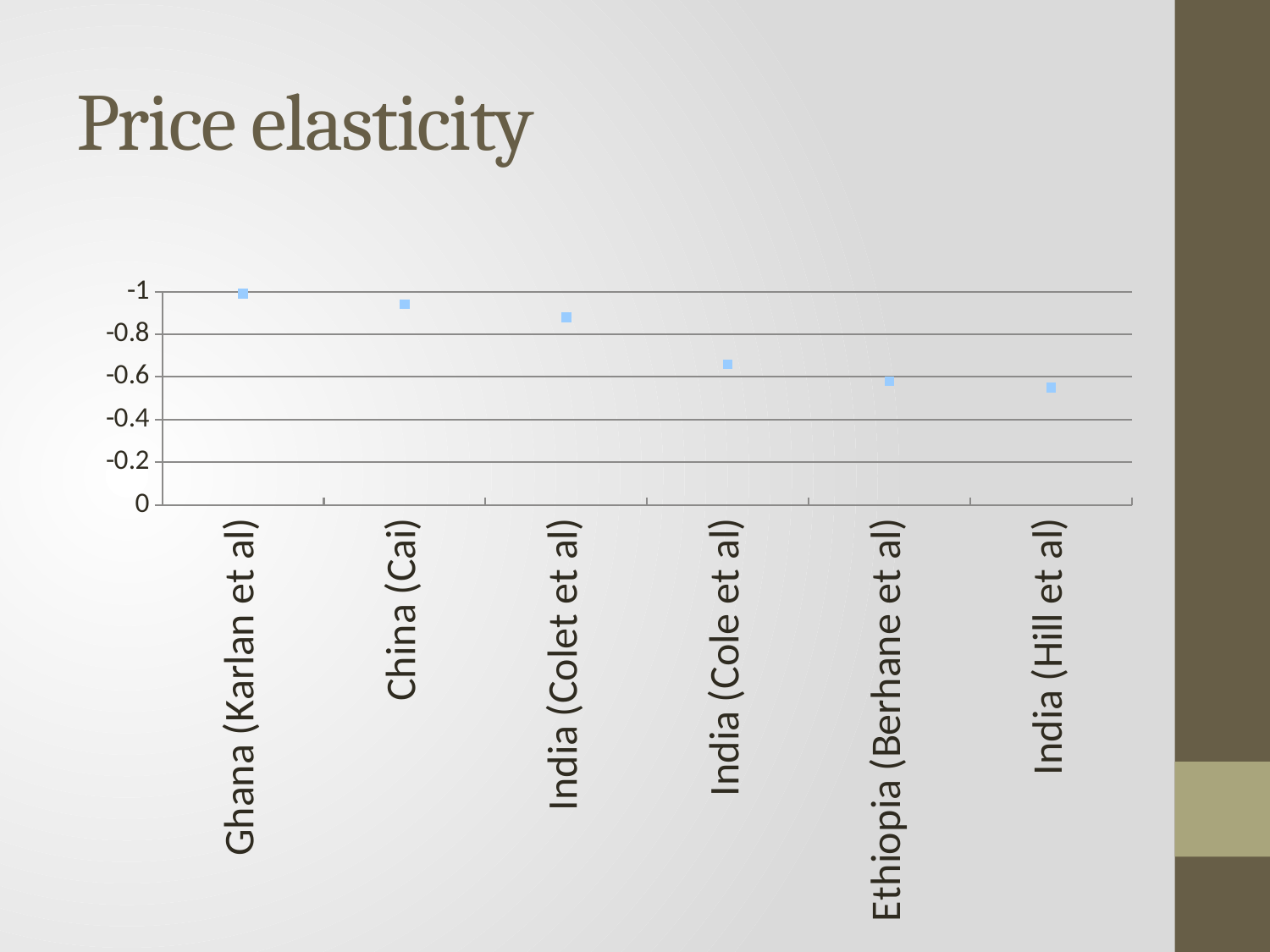
What is the title of the chart? Price elasticity Is the value for India (Hill et al) greater or less than -0.6? greater How many categories are plotted on the x axis? 6 Is the value for India (Colet et al) greater or less than -0.8? less Which category has the lowest (most negative) price elasticity? Ghana (Karlan et al) Do the price elasticity values become more negative or less negative moving from left to right along the x axis? less negative What kind of chart is shown on the slide? scatter chart Is the value for India (Cole et al) greater or less than -0.6? less Which has the more negative price elasticity, Ghana (Karlan et al) or India (Cole et al)? Ghana (Karlan et al) What is the lowest value shown on the y axis? -1